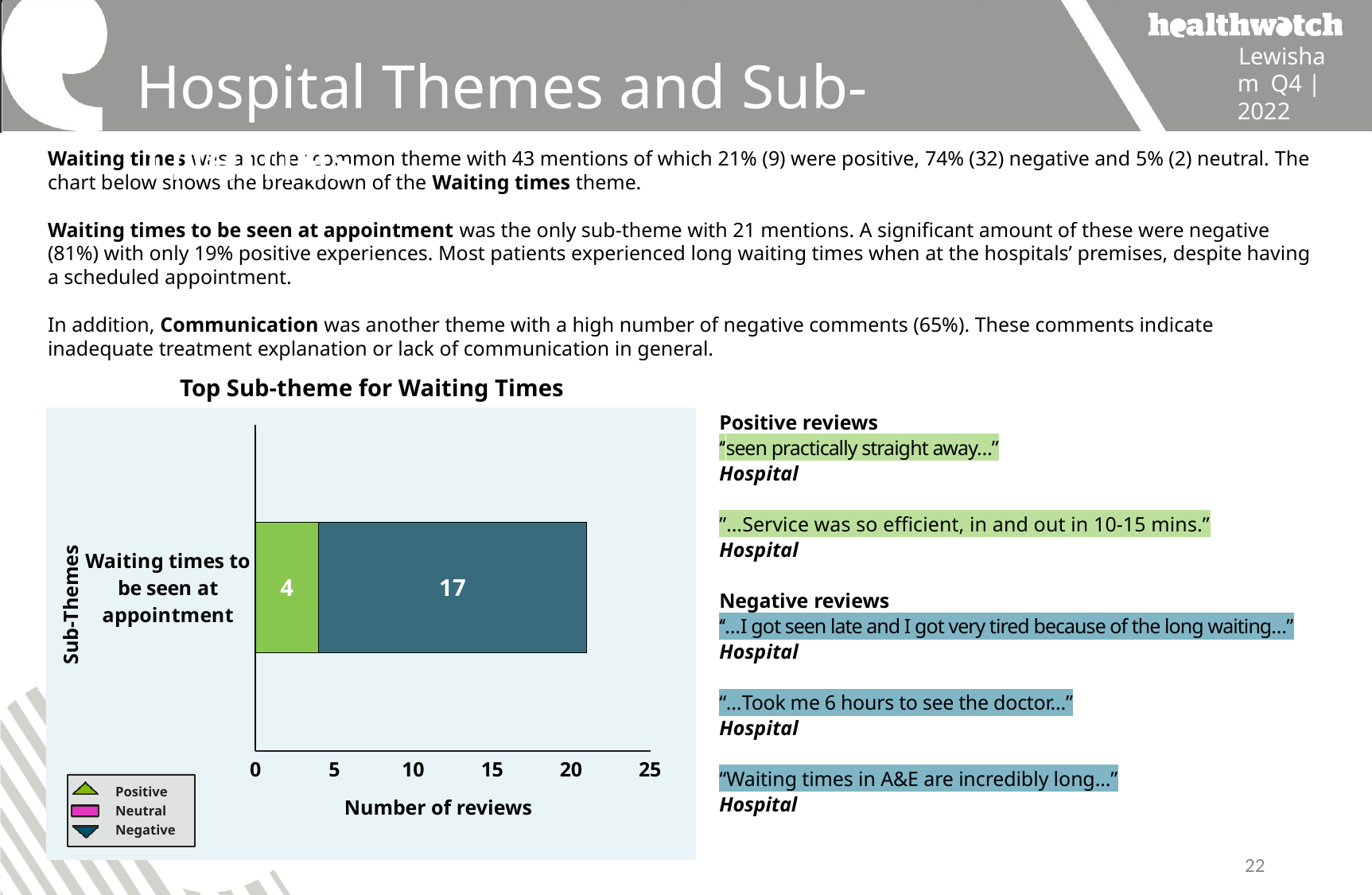
How many series does the legend of the chart 'Top Sub-theme for Waiting Times' list? 3 What kind of chart is 'Top Sub-theme for Waiting Times'? Stacked bar chart What is the title of the chart on the slide? Top Sub-theme for Waiting Times How many sub-theme categories are plotted in the chart 'Top Sub-theme for Waiting Times'? 1 Which series has the largest value in the chart 'Top Sub-theme for Waiting Times'? Negative Which is larger for 'Waiting times to be seen at appointment': the number of positive reviews or the number of negative reviews? Negative Is the total length of the bar for 'Waiting times to be seen at appointment' greater or less than 20? greater What is the label of the horizontal axis in the chart 'Top Sub-theme for Waiting Times'? Number of reviews What is the total number of reviews in the stacked bar for 'Waiting times to be seen at appointment'? 21 What is the difference between the negative and positive review counts for 'Waiting times to be seen at appointment'? 13 In the chart 'Top Sub-theme for Waiting Times', how many positive reviews are shown for 'Waiting times to be seen at appointment'? 4 In the chart 'Top Sub-theme for Waiting Times', how many negative reviews are shown for 'Waiting times to be seen at appointment'? 17